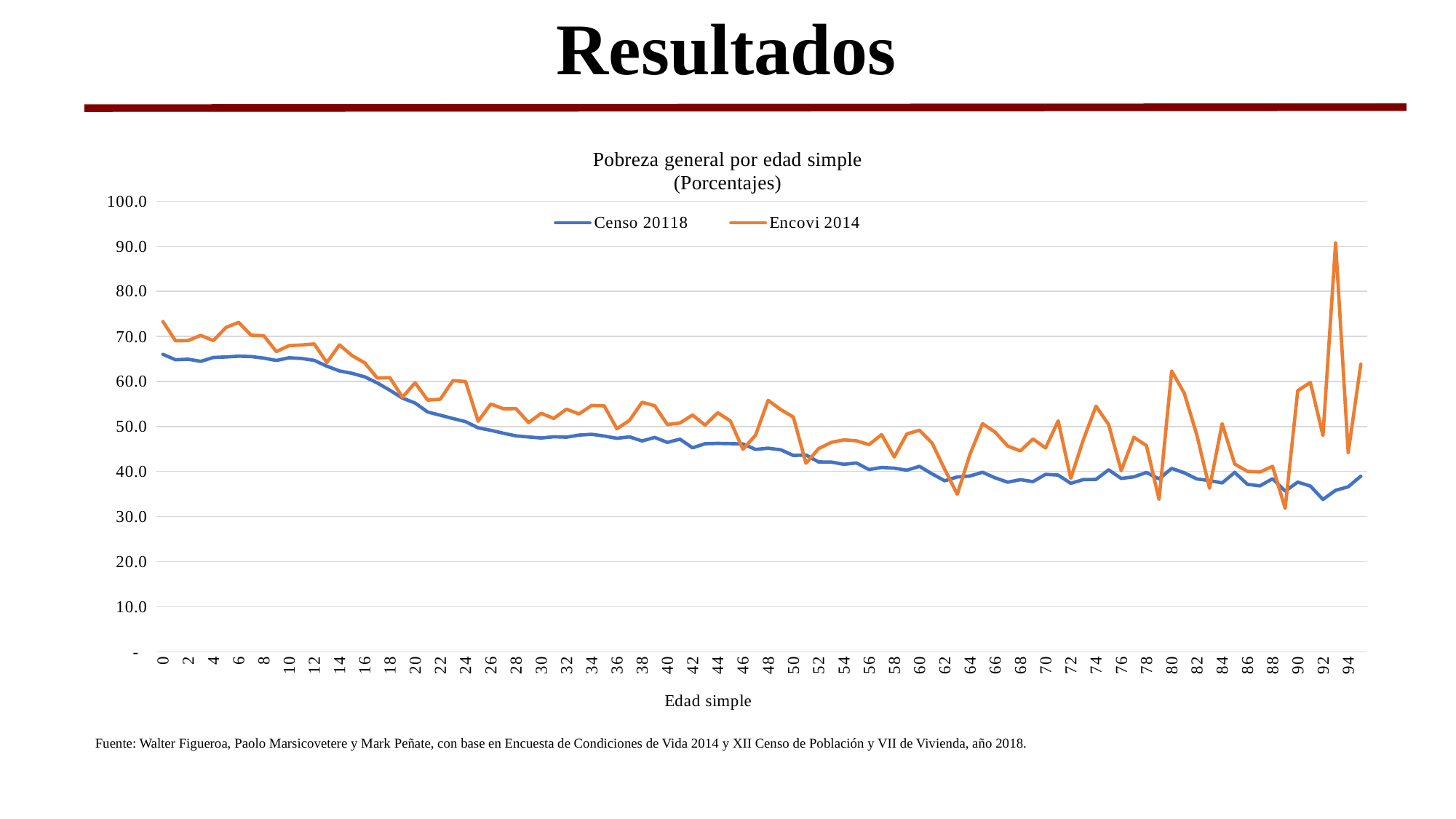
How many series does the legend list? 2 What kind of chart is shown on the slide? line chart Does the Censo 20118 line generally rise or fall from age 0 to age 60? fall What is the title of the x axis? Edad simple Is the Censo 20118 value at age 0 greater or less than 60? greater Is the Encovi 2014 value at age 0 greater or less than 70? greater Which series reaches the highest value anywhere on the chart? Encovi 2014 At age 0, which series has the higher value, Censo 20118 or Encovi 2014? Encovi 2014 Is the Encovi 2014 value at age 89 greater or less than 40? less What are the two series named in the legend? Censo 20118 and Encovi 2014